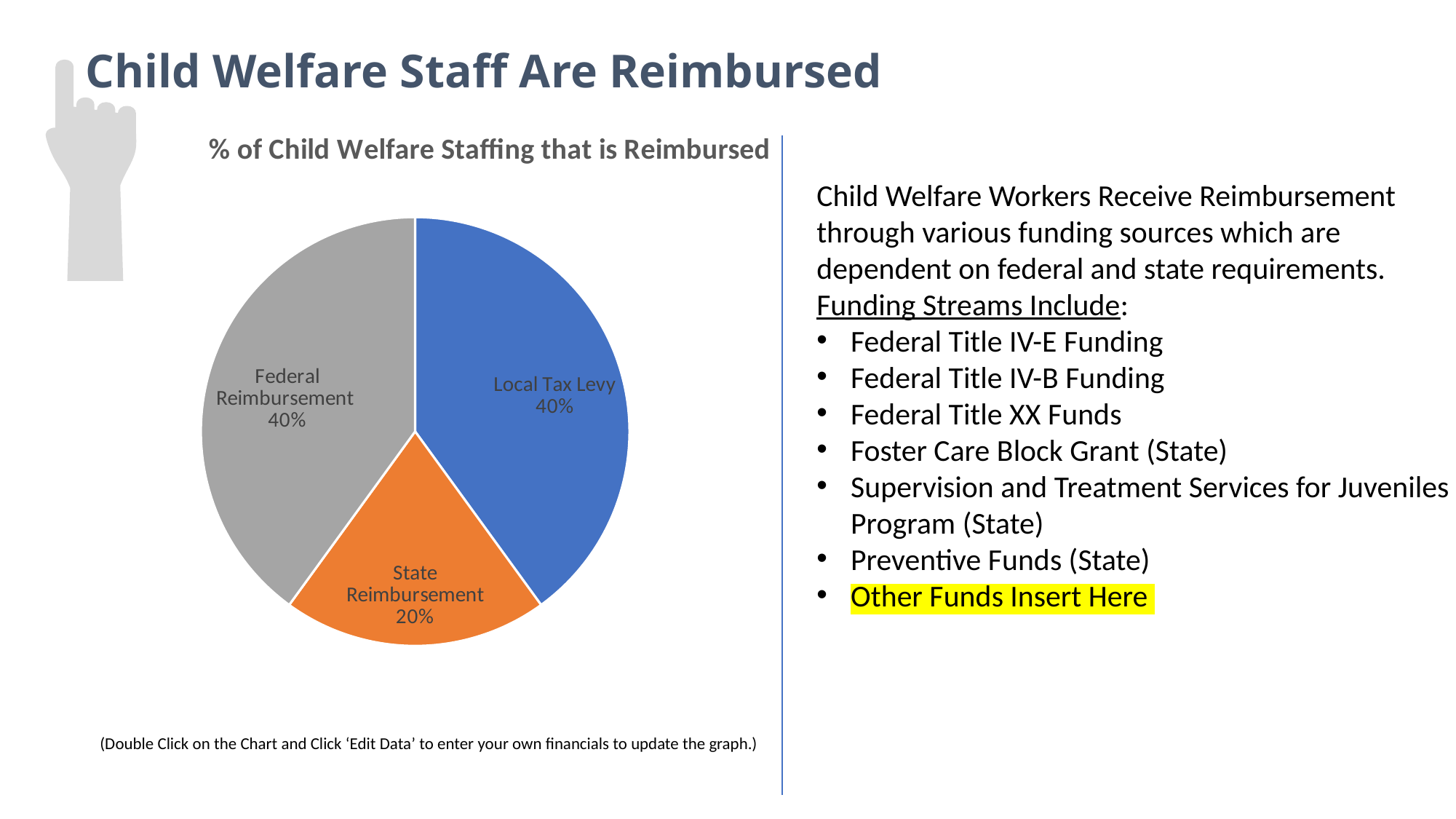
Which category has the smallest slice of the pie? State Reimbursement Which is larger, the Federal Reimbursement slice or the State Reimbursement slice? Federal Reimbursement What colour is the State Reimbursement slice? Orange What share of the pie is Local Tax Levy? 40% What is the difference between the Local Tax Levy share and the State Reimbursement share? 20% What is the combined share of Federal Reimbursement and State Reimbursement? 60% What share of the pie is State Reimbursement? 20% How many slices does the pie chart have? 3 What is the title of the chart? % of Child Welfare Staffing that is Reimbursed What kind of chart is shown on the slide? Pie chart What share of the pie is Federal Reimbursement? 40%